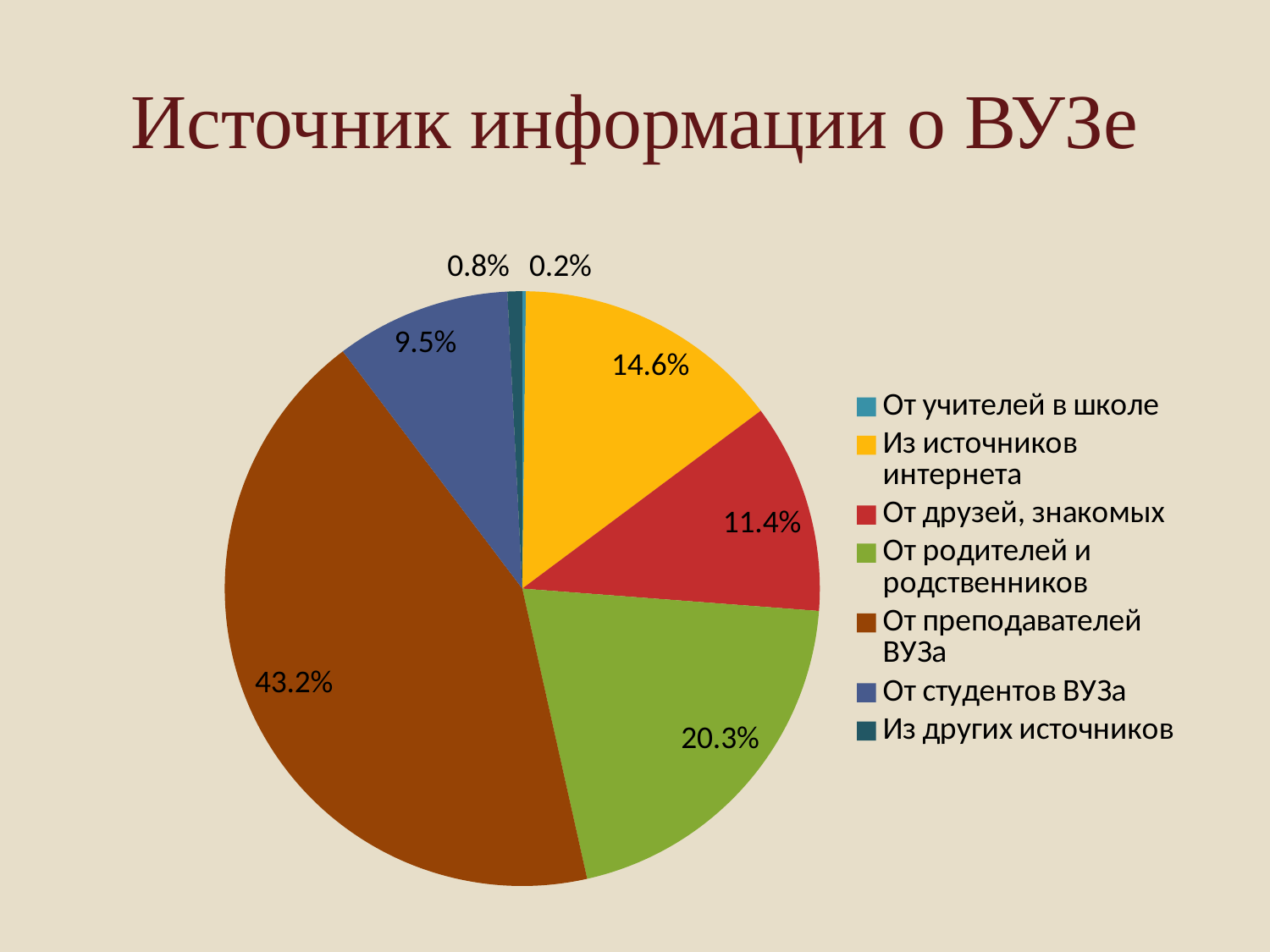
How many slices does the pie chart have? 7 What share of the pie is 'От родителей и родственников'? 20.3% What share of the pie is 'От учителей в школе'? 0.2% What kind of chart is shown on the slide? pie chart What is the title of the chart? Источник информации о ВУЗе What share of the pie is 'От студентов ВУЗа'? 9.5% Which category has the smallest share of the pie? От учителей в школе Which is larger: the share of 'От друзей, знакомых' or the share of 'От студентов ВУЗа'? От друзей, знакомых Which category has the largest share of the pie? От преподавателей ВУЗа What is the difference between the shares of 'От родителей и родственников' and 'От друзей, знакомых'? 8.9%